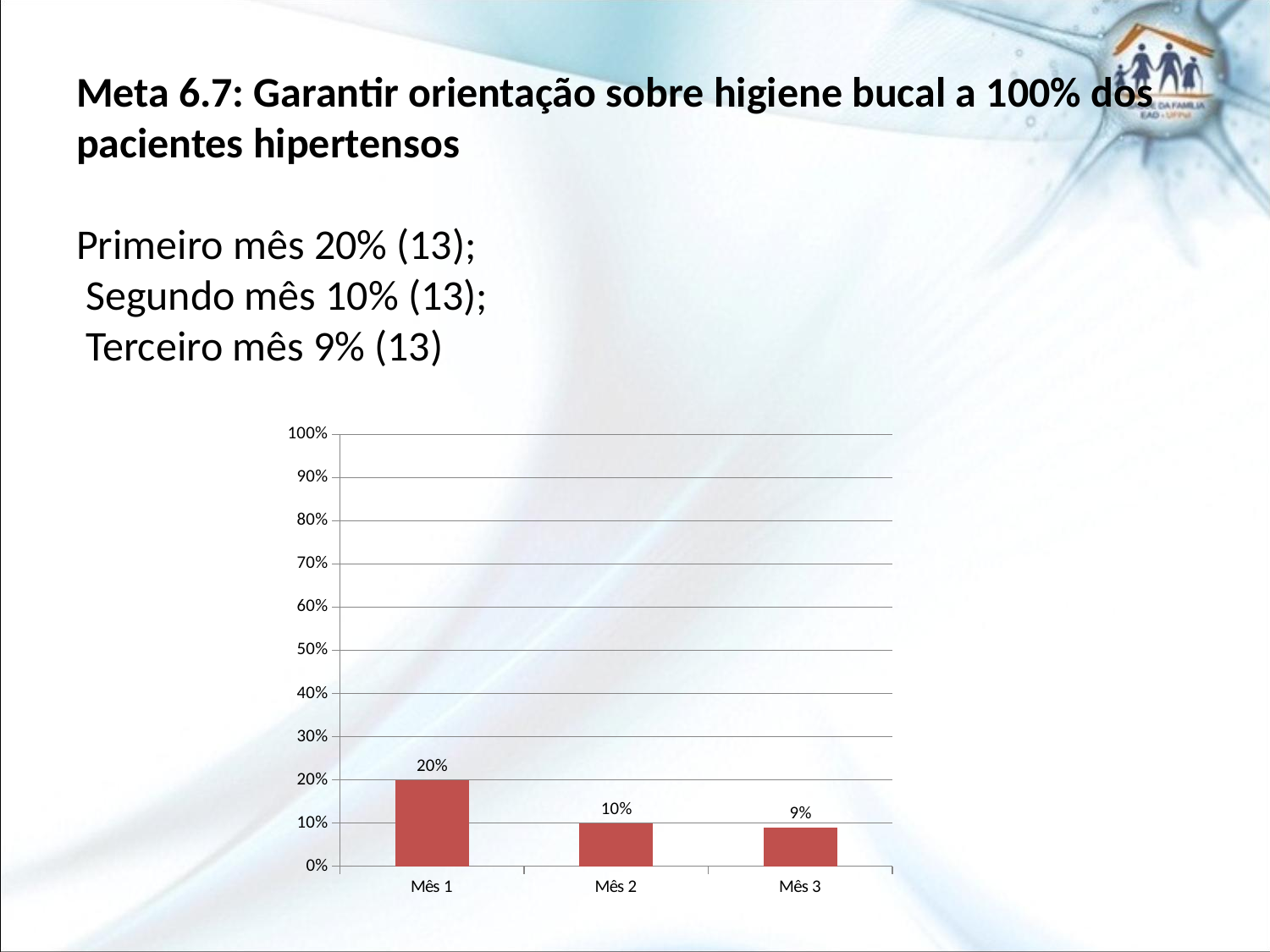
What is the difference between the values for Mês 2 and Mês 3? 1% Which is larger, the value for Mês 1 or the value for Mês 3? Mês 1 Which month has the lowest value? Mês 3 What is the value for Mês 2? 10% Do the values rise or fall from Mês 1 to Mês 3? fall Is the value for Mês 1 greater or less than 30%? less How many categories are shown on the x axis? 3 What kind of chart is shown on the slide? bar chart What is the difference between the values for Mês 1 and Mês 2? 10% What is the value for Mês 3? 9% What is the value for Mês 1? 20% Which month has the highest value? Mês 1